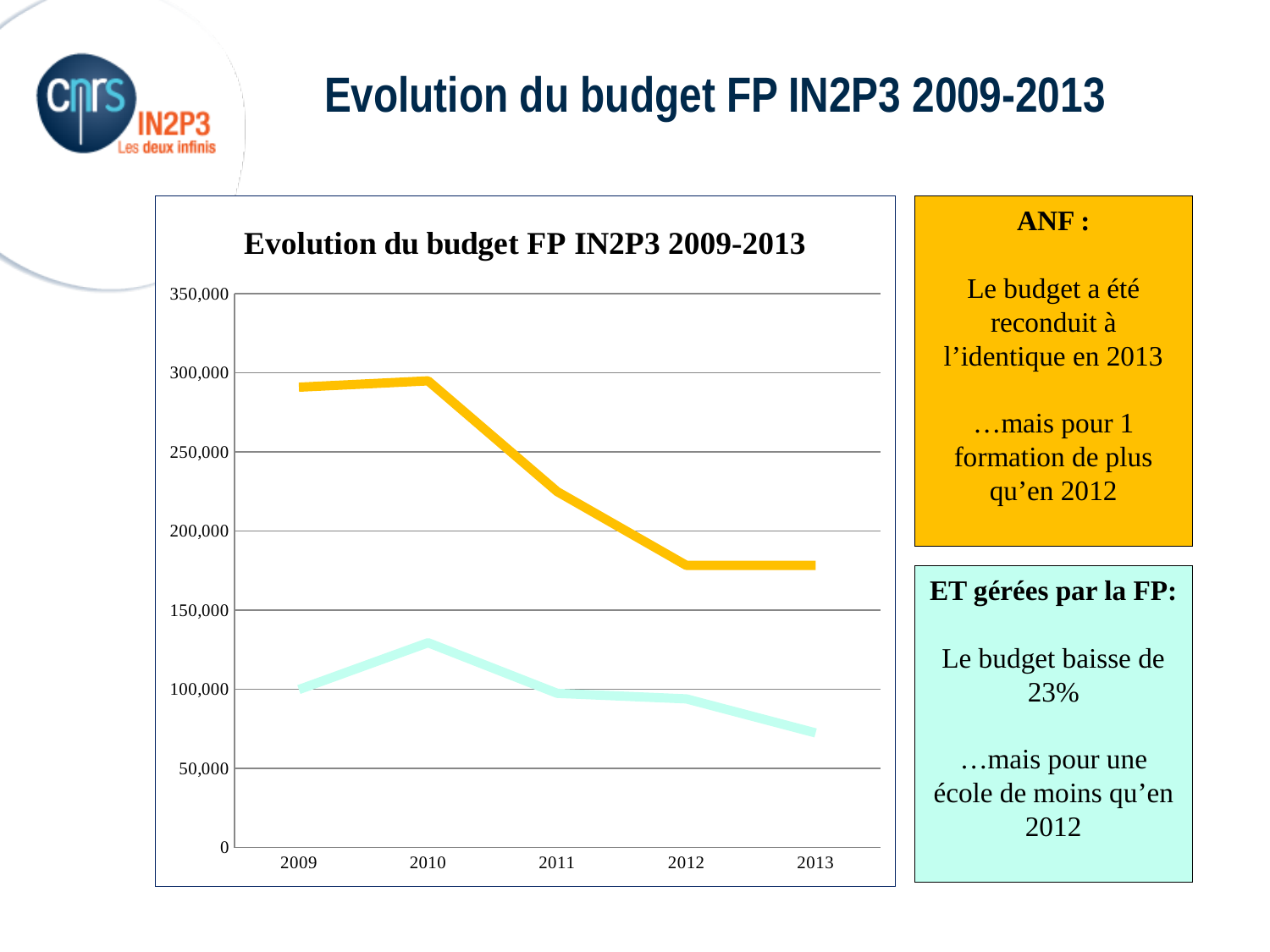
How many years are plotted along the x axis of the chart? 5 What is the title of the chart? Evolution du budget FP IN2P3 2009-2013 How many lines are plotted on the chart? 2 Is the value of the light blue line in 2013 greater or less than 100,000? less What kind of chart is shown on the slide? line chart Is the value of the orange line in 2012 greater or less than 200,000? less In which year does the light blue line reach its lowest value? 2013 Is the value of the orange line in 2009 greater or less than 300,000? less In which year does the light blue line reach its highest value? 2010 Does the light blue line rise or fall between 2010 and 2013? fall